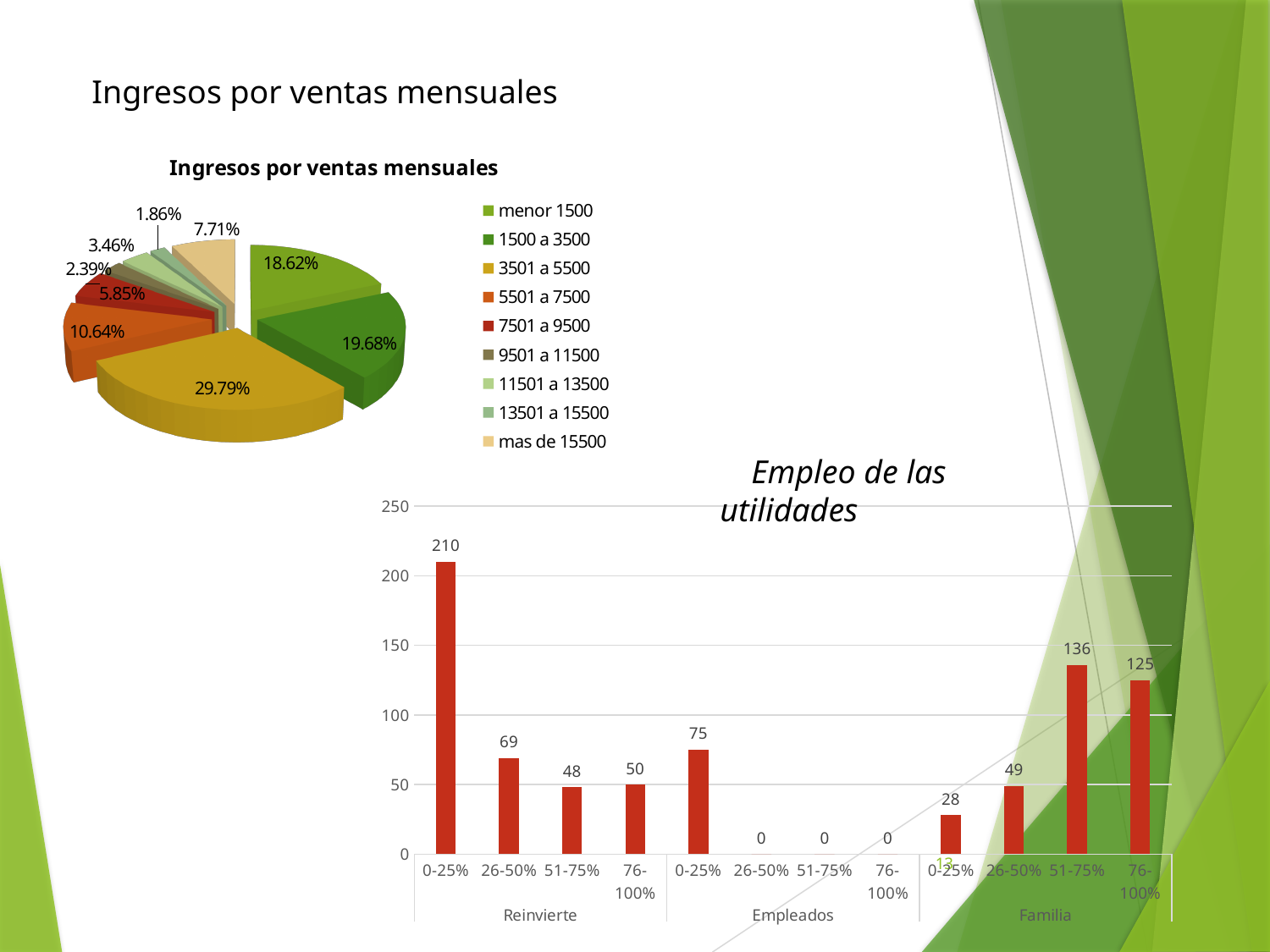
In the pie chart 'Ingresos por ventas mensuales', what is the share for 'mas de 15500'? 7.71% In the pie chart 'Ingresos por ventas mensuales', what share does the '3501 a 5500' slice have? 29.79% In the bar chart 'Empleo de las utilidades', what is the difference between the 0-25% bar under Reinvierte and the 0-25% bar under Empleados? 135 In the pie chart 'Ingresos por ventas mensuales', which category has the smallest slice? 13501 a 15500 In the bar chart 'Empleo de las utilidades', how many bars under Empleados have a value of 0? 3 In the pie chart 'Ingresos por ventas mensuales', which category has the largest slice? 3501 a 5500 What type of chart is 'Empleo de las utilidades'? Bar chart How many categories does the legend of the pie chart 'Ingresos por ventas mensuales' list? 9 In the bar chart 'Empleo de las utilidades', what is the value for 0-25% under Reinvierte? 210 In the bar chart 'Empleo de las utilidades', what is the value for 51-75% under Familia? 136 In the bar chart 'Empleo de las utilidades', which bar is the highest? 0-25% under Reinvierte In the bar chart 'Empleo de las utilidades', which is larger: 26-50% under Reinvierte or 26-50% under Familia? 26-50% under Reinvierte